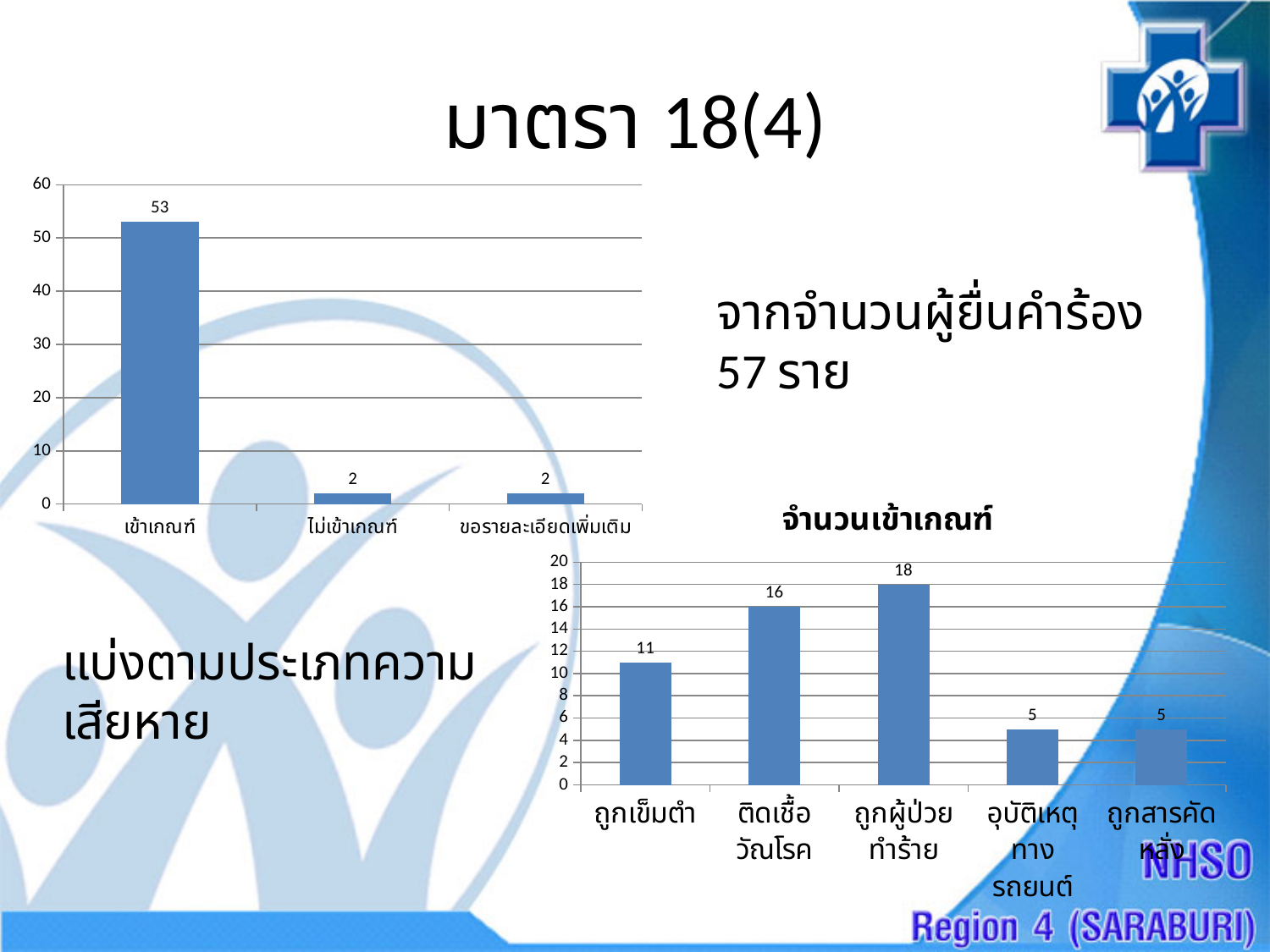
In the chart titled จำนวนเข้าเกณฑ์, which category has the highest value? ถูกผู้ป่วยทำร้าย In the top-left chart, what is the difference between เข้าเกณฑ์ and ขอรายละเอียดเพิ่มเติม? 51 In the top-left chart, what is the value for เข้าเกณฑ์? 53 What type of chart is the top-left chart? Bar chart How many categories are shown in the chart titled จำนวนเข้าเกณฑ์? 5 In the chart titled จำนวนเข้าเกณฑ์, what is the difference between ถูกผู้ป่วยทำร้าย and ถูกเข็มตำ? 7 In the chart titled จำนวนเข้าเกณฑ์, what is the value for ติดเชื้อวัณโรค? 16 In the chart titled จำนวนเข้าเกณฑ์, which is larger: ติดเชื้อวัณโรค or อุบัติเหตุทางรถยนต์? ติดเชื้อวัณโรค In the top-left chart, which category has the highest value? เข้าเกณฑ์ What is the title of the bottom-right chart? จำนวนเข้าเกณฑ์ How many categories are shown in the top-left chart? 3 In the top-left chart, what is the value for ไม่เข้าเกณฑ์? 2